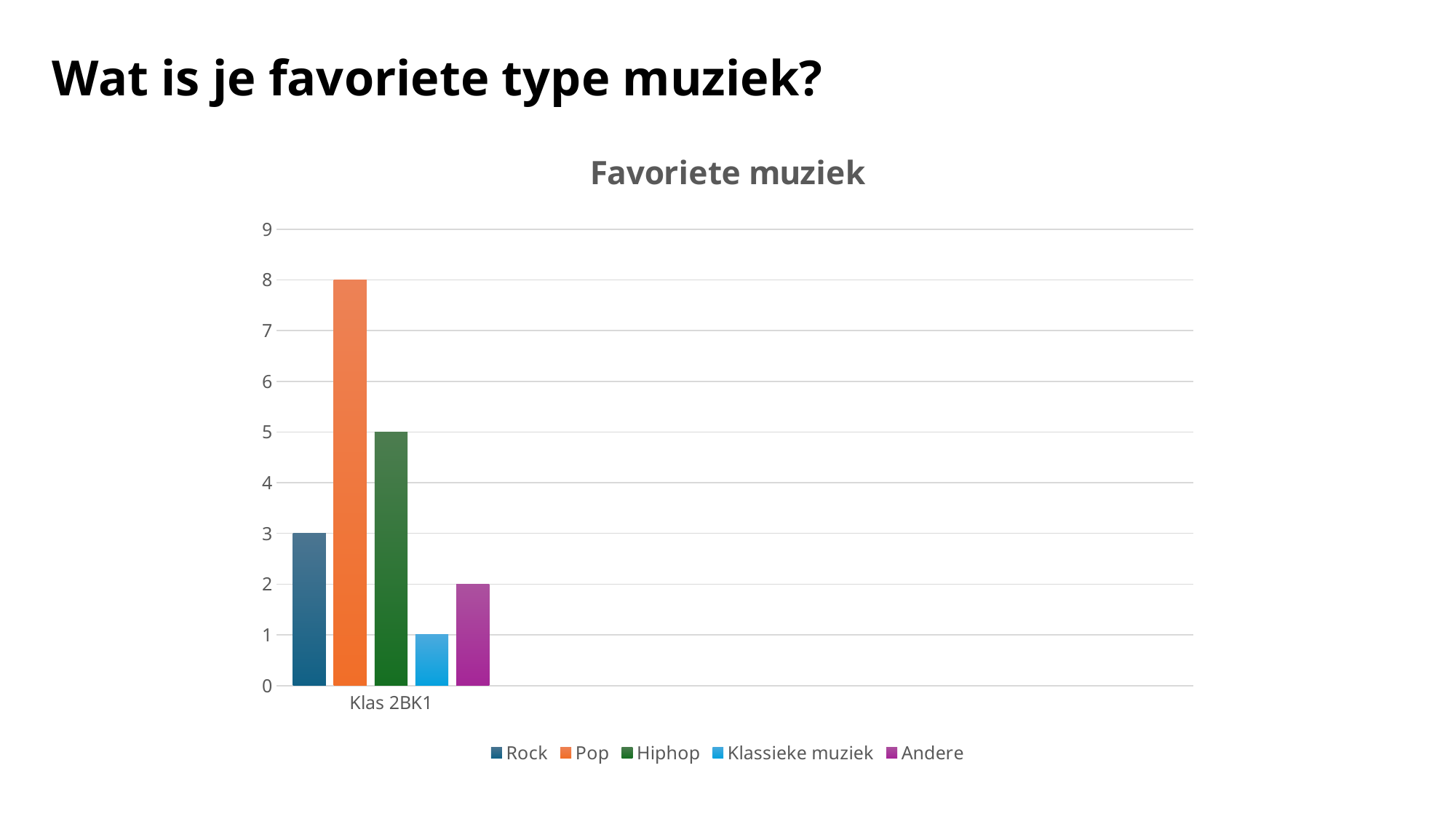
What type of chart is shown on the slide? bar chart What is the title of the chart? Favoriete muziek What is the value for Hiphop for Klas 2BK1? 5 How many series does the legend list? 5 What is the value for Klassieke muziek for Klas 2BK1? 1 Which music type has the highest value? Pop What is the label of the category on the x axis? Klas 2BK1 What is the difference between the values for Pop and Hiphop? 3 What is the value for Rock for Klas 2BK1? 3 What is the value for Pop for Klas 2BK1? 8 Which is larger, the value for Rock or the value for Andere? Rock Which music type has the lowest value? Klassieke muziek